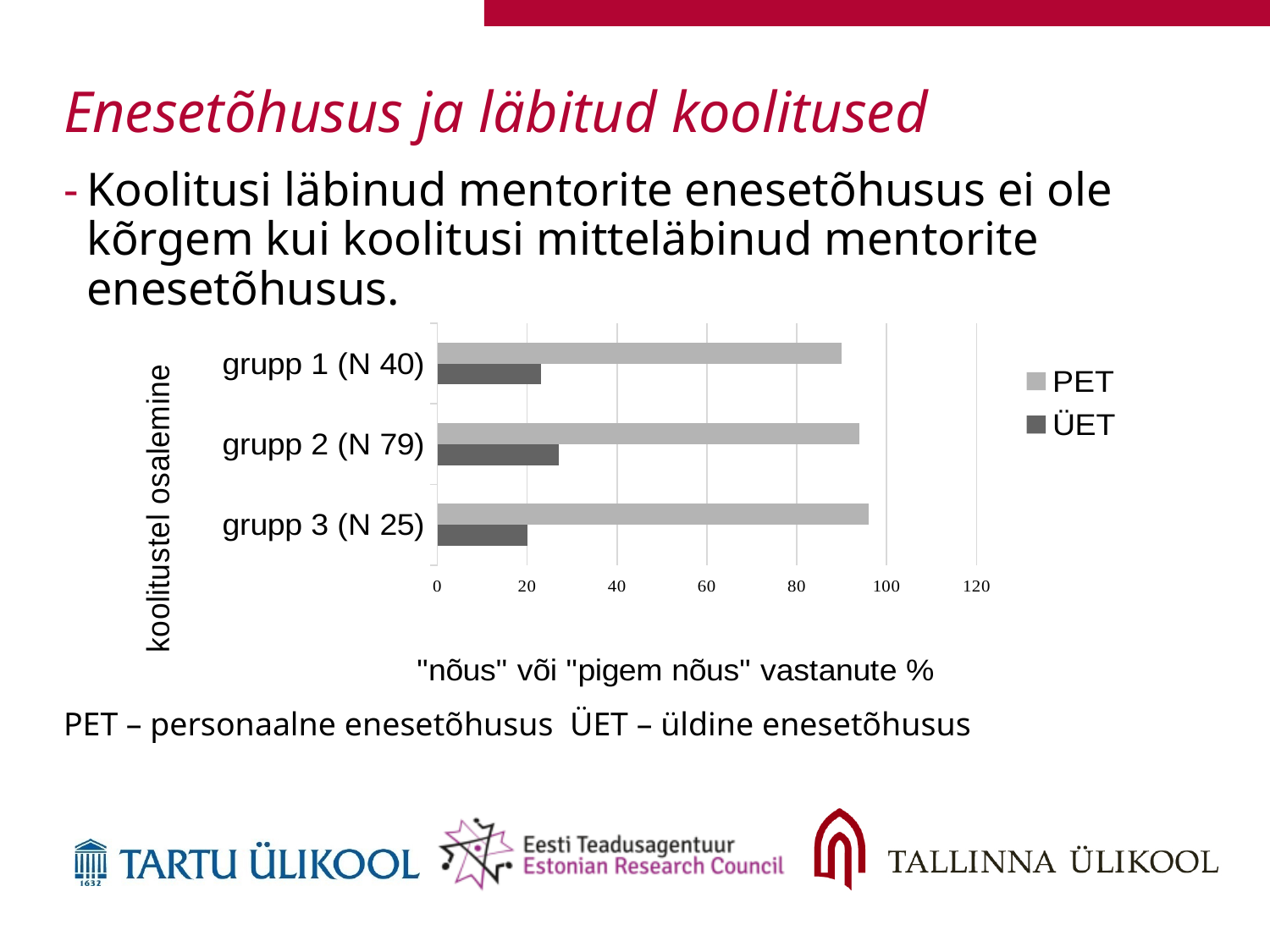
Is the ÜET value for grupp 2 (N 79) greater or less than 20? greater How many groups (categories) are plotted on the chart? 3 For grupp 2 (N 79), which series has the larger value, PET or ÜET? PET Which group has the highest ÜET value? grupp 2 (N 79) Is the PET value for grupp 2 (N 79) greater or less than 60? greater Is the PET value for grupp 3 (N 25) greater or less than 100? less What are the two series named in the chart legend? PET and ÜET What is the x-axis title of the chart? "nõus" või "pigem nõus" vastanute % What kind of chart is shown on the slide? bar chart How many series does the chart legend list? 2